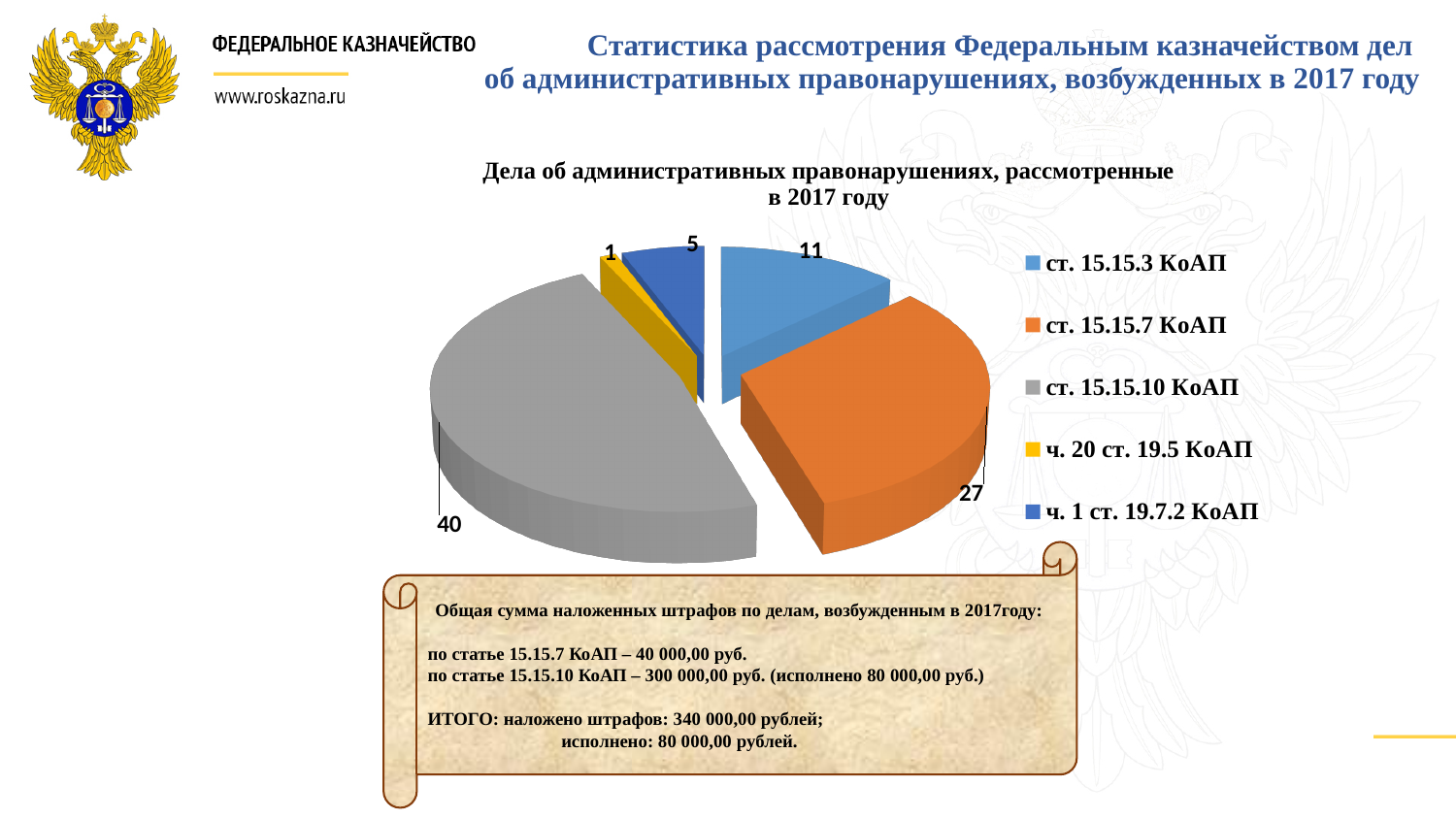
What kind of chart is shown on the slide? Pie chart How many entries does the legend of the pie chart list? 5 Which is larger in the pie chart: ст. 15.15.3 КоАП or ч. 1 ст. 19.7.2 КоАП? ст. 15.15.3 КоАП Which category has the smallest slice in the pie chart? ч. 20 ст. 19.5 КоАП What is the value for ст. 15.15.3 КоАП in the pie chart? 11 Which category has the largest slice in the pie chart? ст. 15.15.10 КоАП How many slices does the pie chart have? 5 What is the title of the pie chart? Дела об административных правонарушениях, рассмотренные в 2017 году What is the value for ст. 15.15.10 КоАП in the pie chart? 40 What is the difference between the values for ст. 15.15.10 КоАП and ст. 15.15.7 КоАП? 13 What is the value for ст. 15.15.7 КоАП in the pie chart? 27 What is the value for ч. 20 ст. 19.5 КоАП in the pie chart? 1